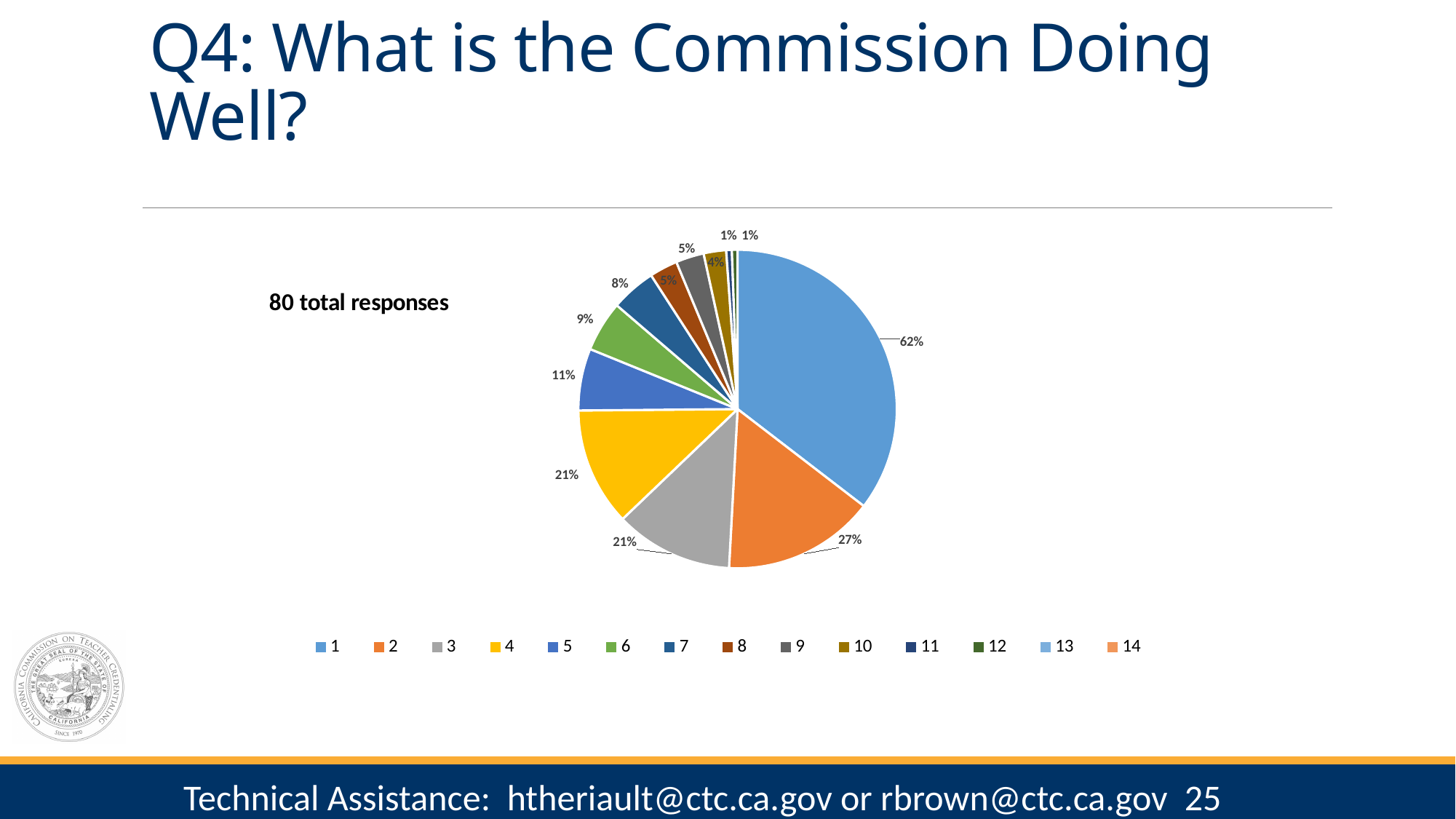
How many categories does the legend of the pie chart list? 14 What is the difference in percentage points between category 1 and category 2 in the pie chart? 35 What percentage is shown for category 1 in the pie chart? 62% What percentage is shown for category 2 in the pie chart? 27% What kind of chart is shown on the slide? pie chart Which category has the largest slice in the pie chart? 1 What percentage is shown for category 7 in the pie chart? 8% What percentage is shown for category 6 in the pie chart? 9% Which is larger in the pie chart, category 5 or category 6? 5 What percentage is shown for category 5 in the pie chart? 11% How many total responses does the slide say the chart is based on? 80 total responses What percentage is shown for category 10 in the pie chart? 4%